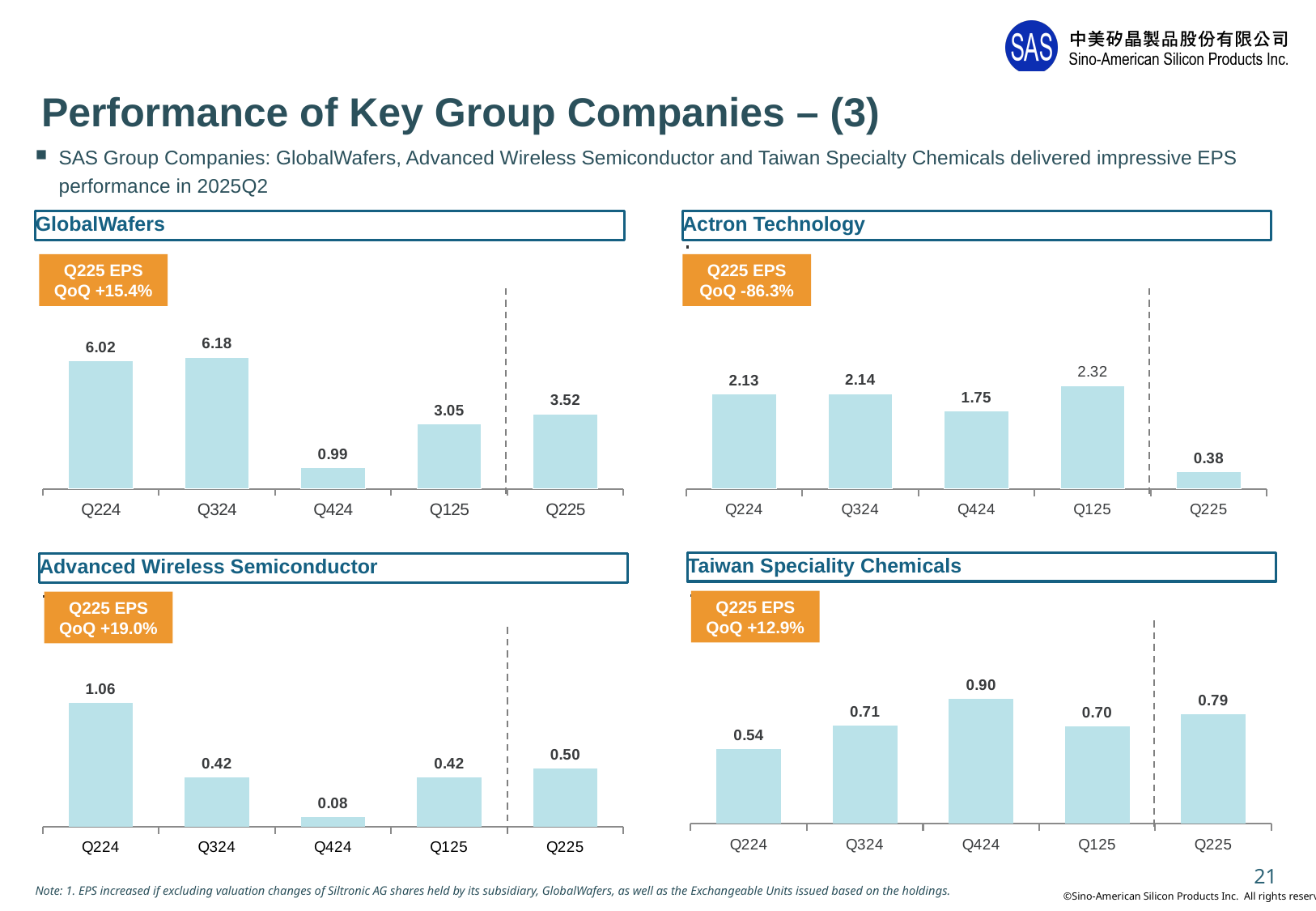
How many quarters are shown in the Taiwan Speciality Chemicals chart? 5 In the GlobalWafers chart, which quarter has the highest EPS? Q324 What type of chart is used for the Actron Technology data? Bar chart In the GlobalWafers chart, what is the EPS value for Q225? 3.52 In the GlobalWafers chart, what is the difference between the Q324 and Q424 values? 5.19 In the Advanced Wireless Semiconductor chart, which is larger, the Q224 value or the Q225 value? Q224 In the Actron Technology chart, which quarter has the lowest EPS? Q225 In the Actron Technology chart, what is the EPS value for Q125? 2.32 In the Actron Technology chart, what is the difference between the Q125 and Q225 values? 1.94 In the Taiwan Speciality Chemicals chart, what is the EPS value for Q324? 0.71 In the Taiwan Speciality Chemicals chart, which quarter has the highest EPS? Q424 In the Advanced Wireless Semiconductor chart, what is the EPS value for Q424? 0.08